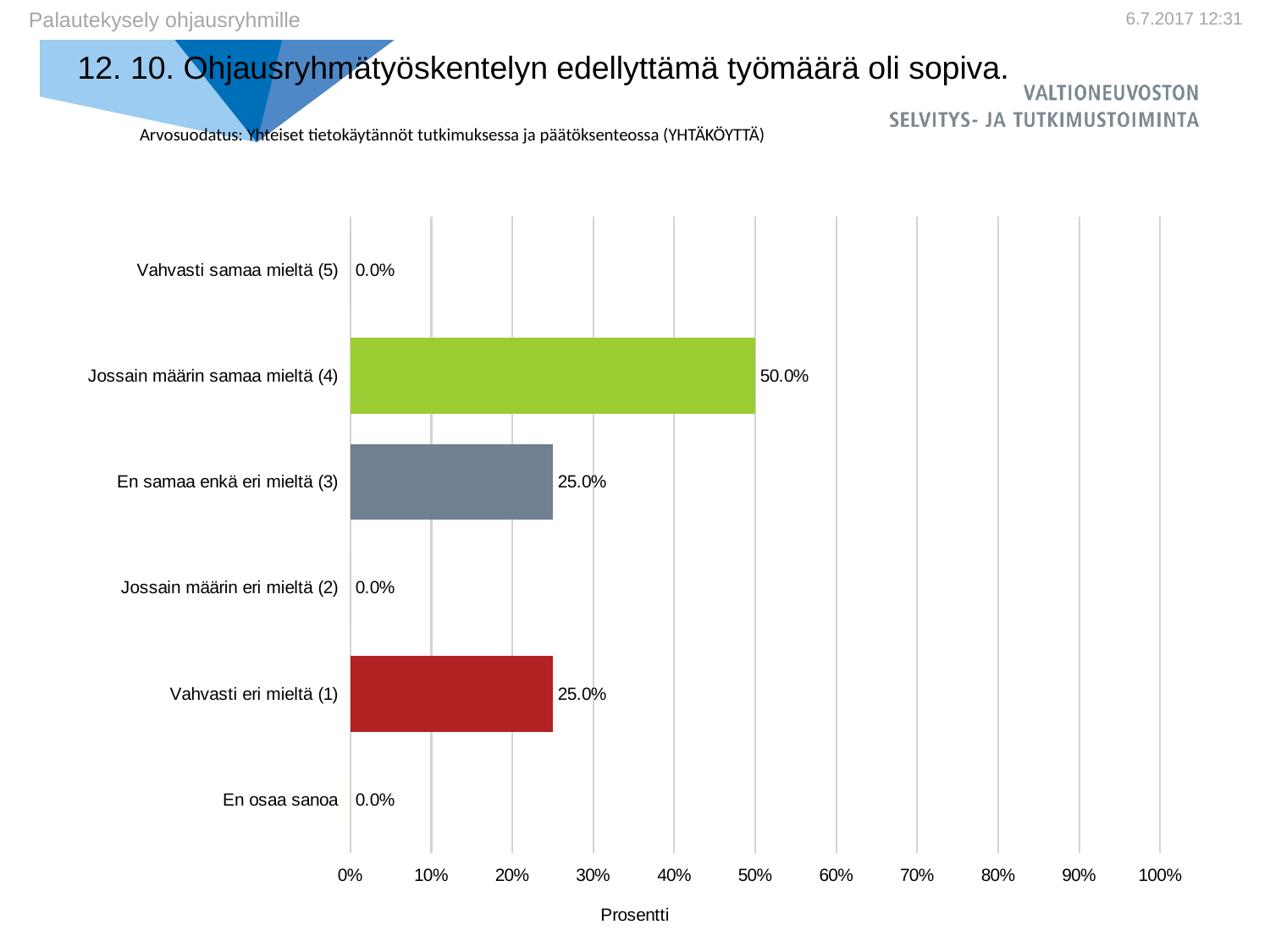
What colour is the bar for "Vahvasti eri mieltä (1)"? Red Which is larger, the value for "Jossain määrin samaa mieltä (4)" or the value for "Vahvasti eri mieltä (1)"? Jossain määrin samaa mieltä (4) What kind of chart is shown on the slide? Bar chart What is the value for "En samaa enkä eri mieltä (3)"? 25.0% What is the value for "Vahvasti samaa mieltä (5)"? 0.0% What is the value for "En osaa sanoa"? 0.0% What is the difference between the values for "Jossain määrin samaa mieltä (4)" and "En samaa enkä eri mieltä (3)"? 25.0% How many categories are shown on the chart? 6 What is the label of the horizontal axis? Prosentti What is the value for "Vahvasti eri mieltä (1)"? 25.0% What is the value for "Jossain määrin samaa mieltä (4)"? 50.0% Which category has the highest value? Jossain määrin samaa mieltä (4)